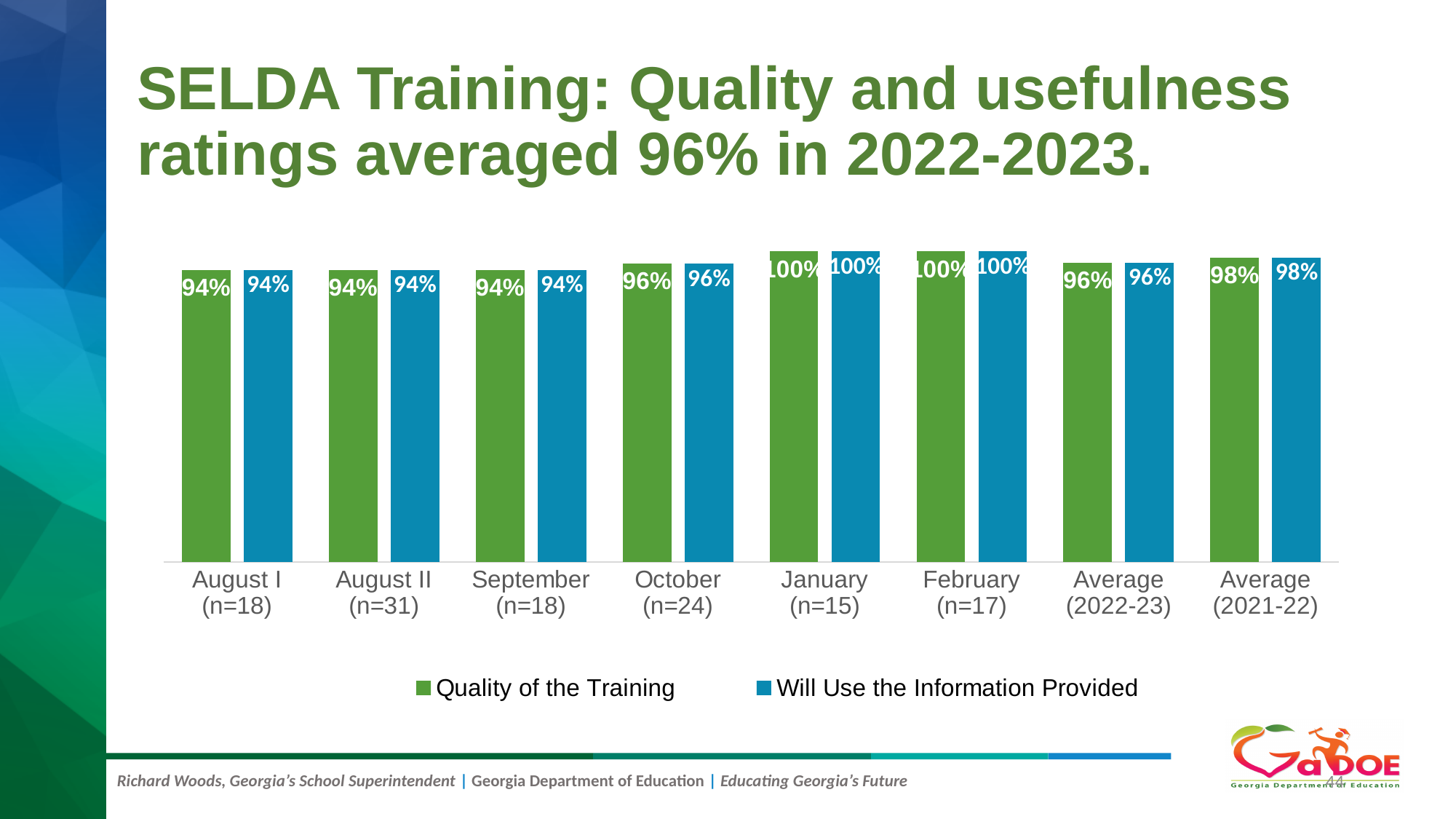
What kind of chart is shown on the slide? bar chart What is the Quality of the Training value for October (n=24)? 96% How many series does the legend list? 2 What is the difference between the Quality of the Training values for February (n=17) and September (n=18)? 6% Which series is shown in blue? Will Use the Information Provided How many categories are shown on the x axis? 8 What is the Will Use the Information Provided value for August II (n=31)? 94% What is the Quality of the Training value for Average (2022-23)? 96% What is the Quality of the Training value for Average (2021-22)? 98% What is the difference between the Quality of the Training values for Average (2021-22) and Average (2022-23)? 2% Which is larger: the Will Use the Information Provided value for Average (2021-22) or for Average (2022-23)? Average (2021-22) What is the Will Use the Information Provided value for January (n=15)? 100%